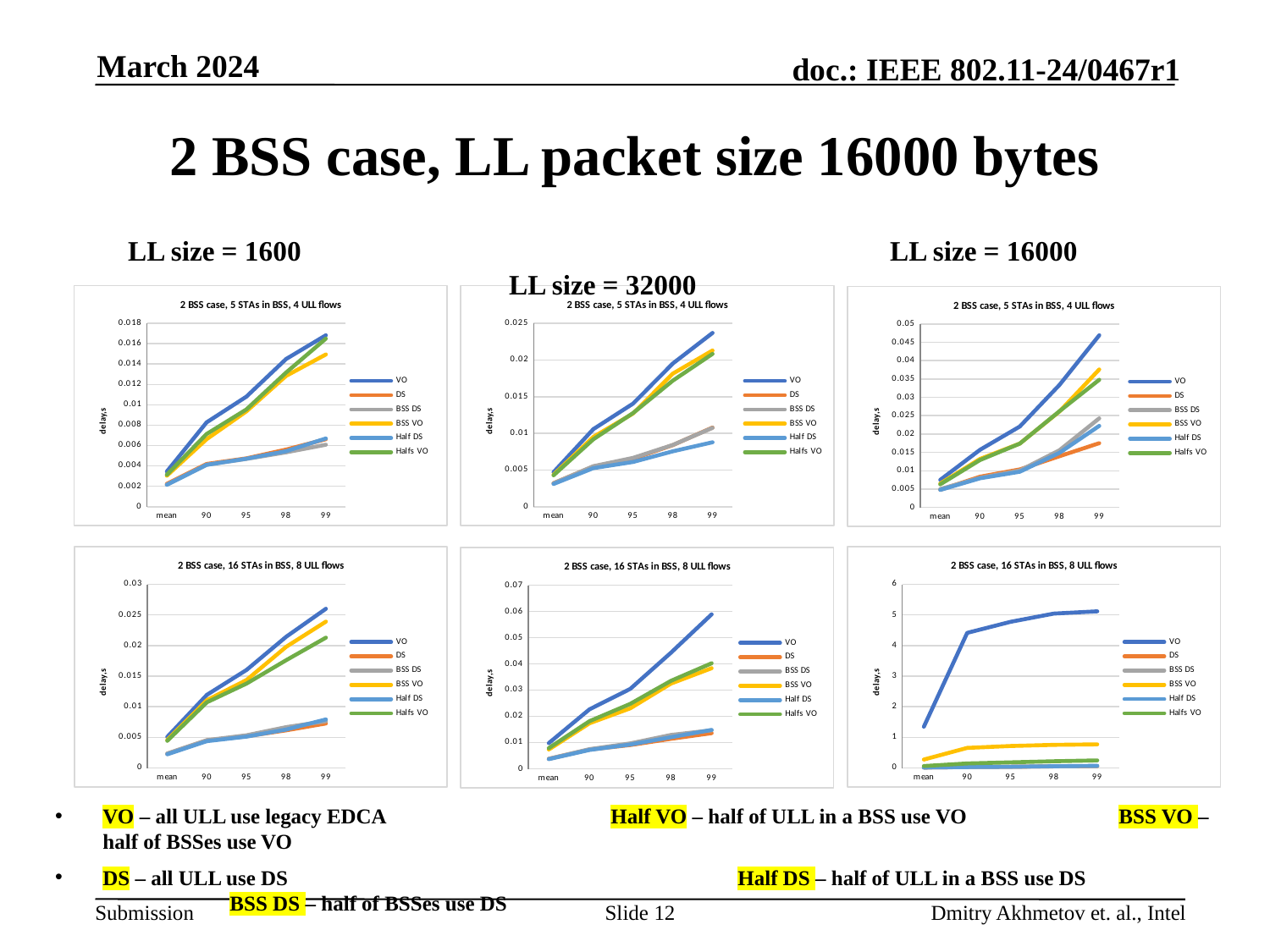
In the bottom-right chart, which series has the highest value at the 99 category? VO What kind of chart is the top-left chart on the slide? line chart How many series does the legend of the bottom-right chart list? 6 In the bottom-right chart, is the value of BSS VO at 99 greater or less than 1? less How many categories are shown on the x axis of the top-middle chart? 5 In the top-left chart, which series has the highest value at the 99 category? VO In the top-left chart, is the value of VO at 99 greater or less than 0.015? greater What is the title of the bottom-middle chart? 2 BSS case, 16 STAs in BSS, 8 ULL flows In the bottom-right chart, is the value of VO at 90 greater or less than 4? greater In the bottom-left chart, does the VO series rise or fall from mean to 99 along the x axis? rise